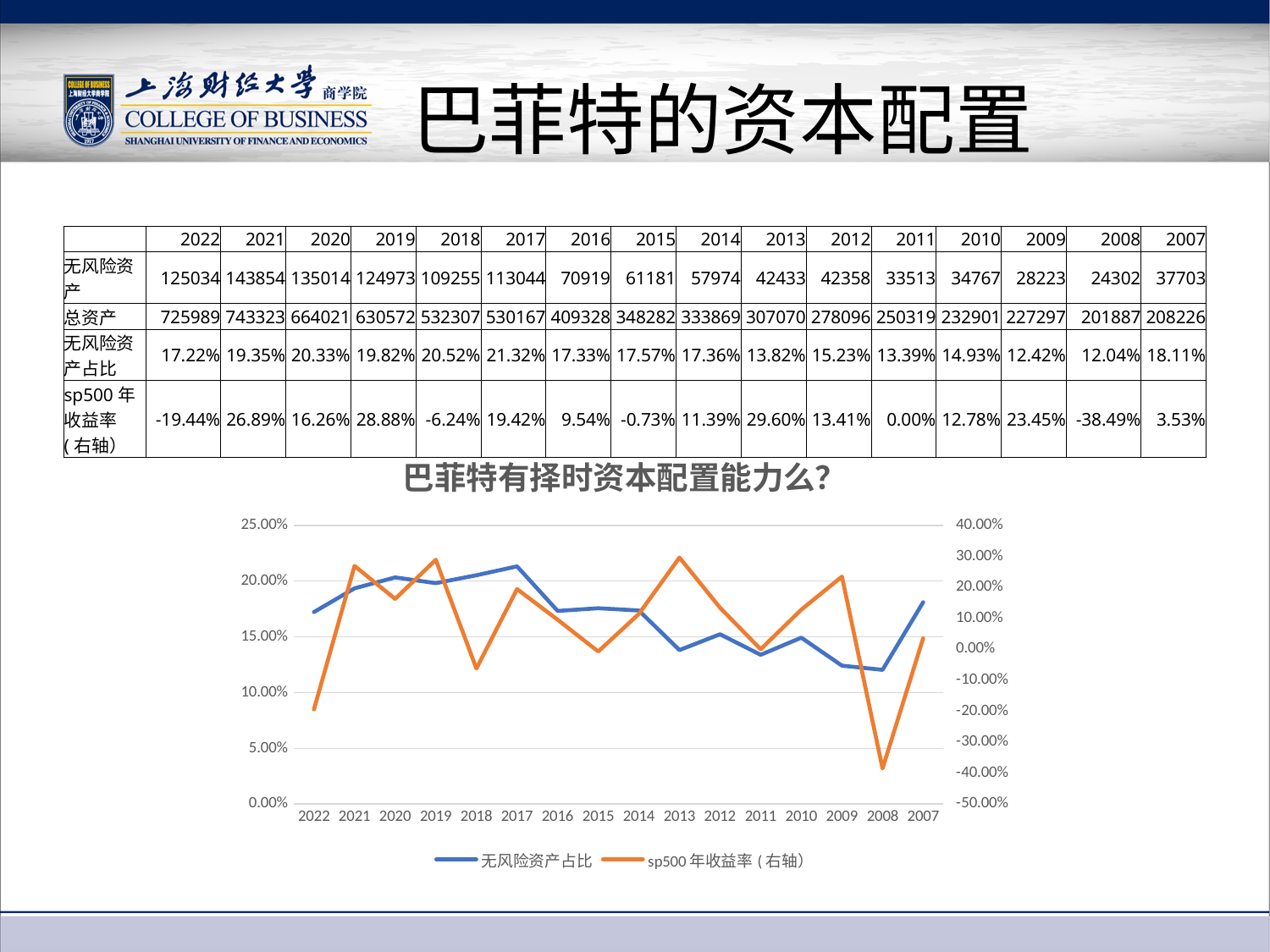
In which year is 无风险资产占比 highest? 2017 Which series is plotted on the right axis according to the legend? sp500 年收益率（右轴） What kind of chart is shown on the slide? line chart What is the sp500 年收益率 for 2008? -38.49% In which year is 无风险资产占比 lowest? 2008 Which year has the larger 无风险资产占比, 2021 or 2022? 2021 How many series does the chart legend list? 2 What is the difference between 无风险资产占比 in 2017 and in 2008? 9.28% What is the value of 无风险资产占比 for 2017? 21.32% Is the sp500 年收益率 for 2022 greater or less than 0.00%? less How many years are plotted along the x axis of the chart? 16 In which year is the sp500 年收益率 lowest? 2008